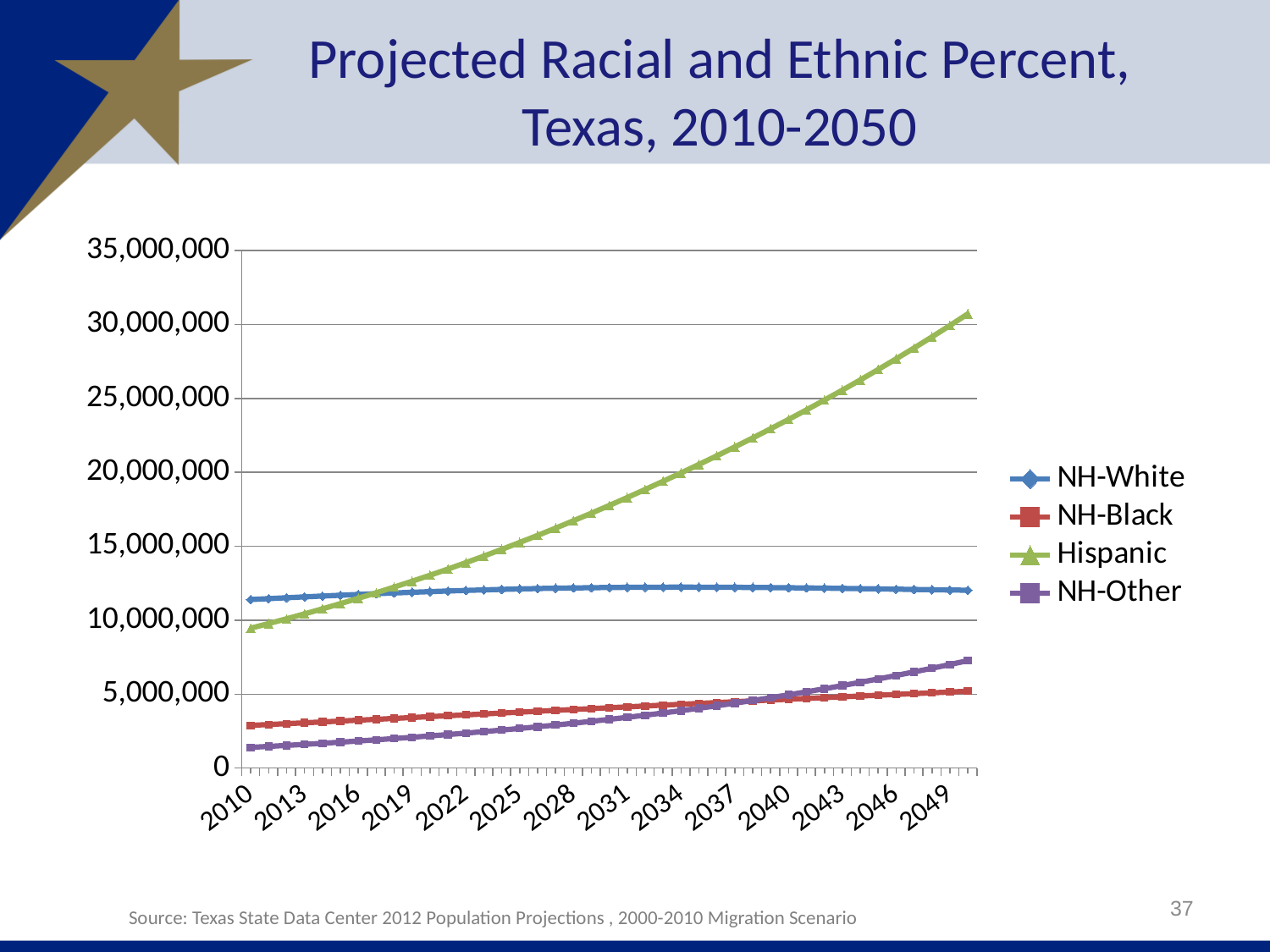
What colour is the Hispanic line in the legend? green Is the value for Hispanic in 2050 greater or less than 25,000,000? greater Which series has the lowest value in 2010? NH-Other Which series has the highest value in 2050? Hispanic Does the Hispanic series rise or fall from 2010 to 2050? rise In 2050, which is larger: NH-Black or NH-Other? NH-Other In 2010, which is larger: NH-White or Hispanic? NH-White Is the value for NH-White in 2010 greater or less than 10,000,000? greater What kind of chart is shown on the slide? line chart Is the value for NH-Black in 2010 greater or less than 5,000,000? less Does the NH-Other series rise or fall from 2010 to 2050? rise How many series does the legend list? 4